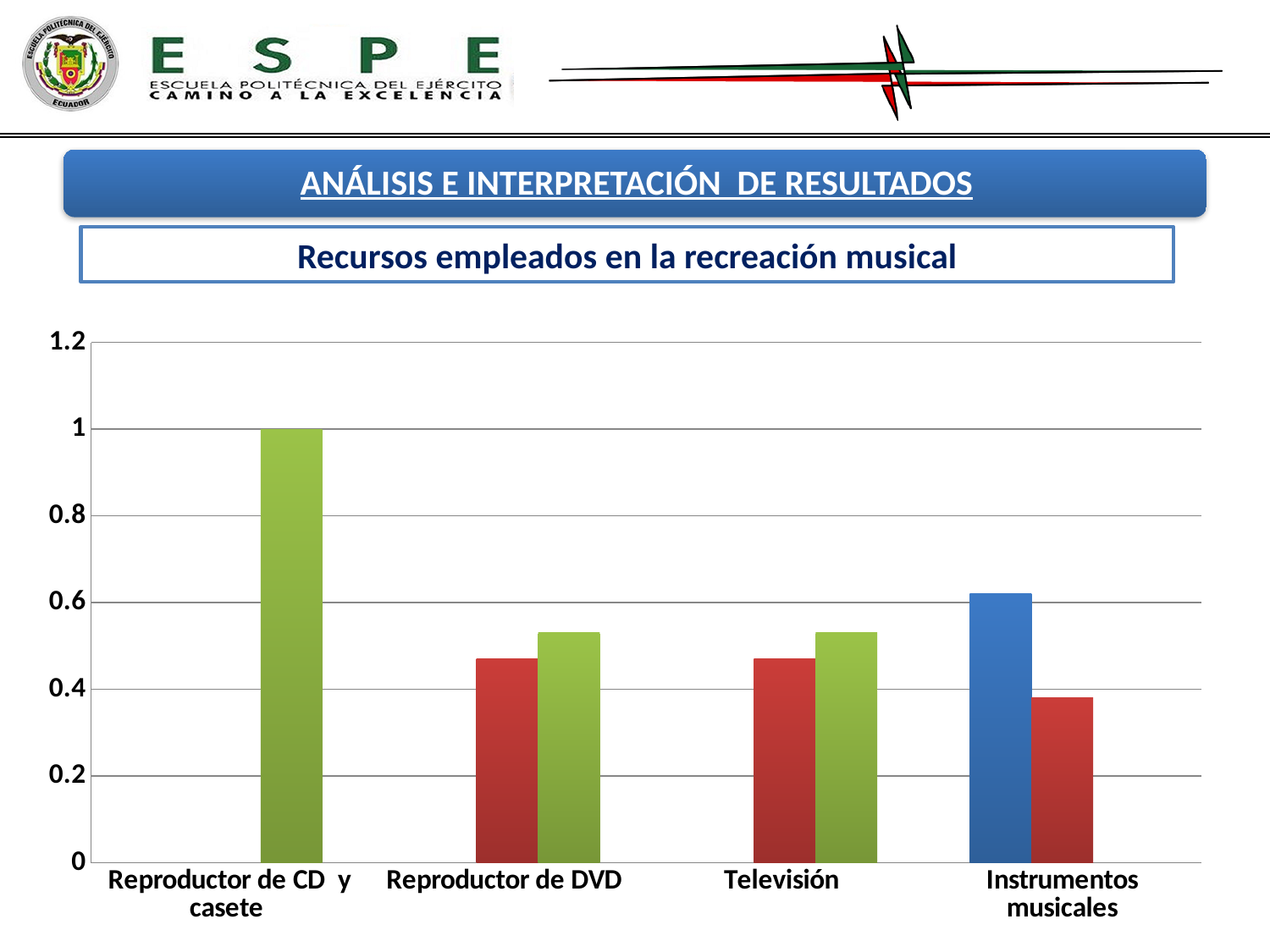
What is the value of the green bar for Reproductor de CD y casete? 1 For Reproductor de DVD, which bar is taller, the red one or the green one? the green one How many categories are shown on the x axis of the chart? 4 Is the value of the red bar for Reproductor de DVD greater or less than 0.6? less Is the value of the red bar for Instrumentos musicales greater or less than 0.6? less Which category has the tallest bar in the chart? Reproductor de CD y casete For Instrumentos musicales, which bar is taller, the blue one or the red one? the blue one Which category is the only one with a blue bar? Instrumentos musicales What is the title shown above the chart? Recursos empleados en la recreación musical Is the value of the green bar for Televisión greater or less than 0.4? greater What kind of chart is shown on the slide? bar chart